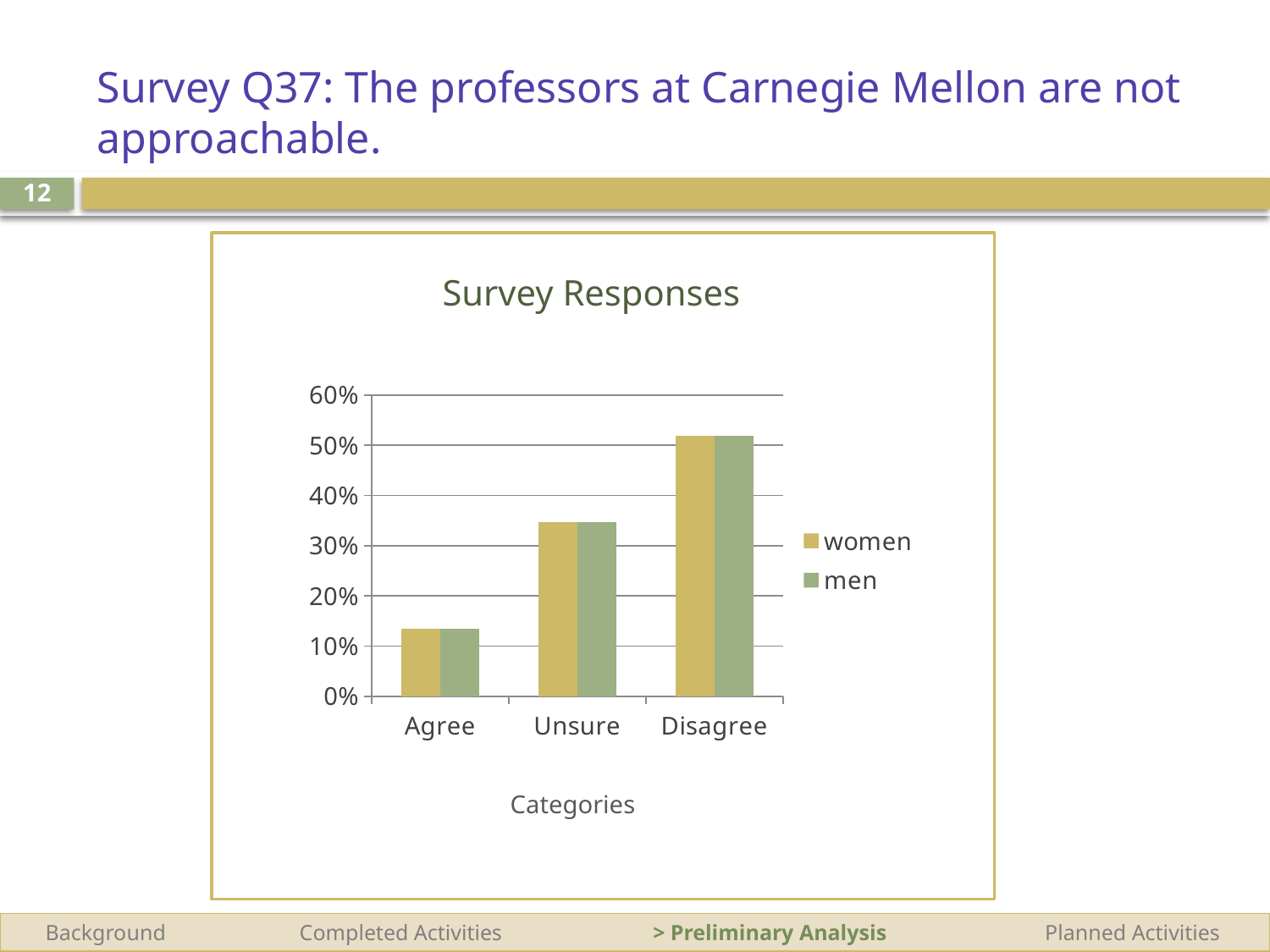
How many series does the legend list? 2 What is the label of the x axis? Categories Which category has the lowest value for men? Agree Is the value for men in the Disagree category greater or less than 40%? greater How many categories are shown on the x axis? 3 Is the value for women in the Agree category greater or less than 20%? less What kind of chart is shown on the slide? bar chart Is the value for men in the Unsure category greater or less than 40%? less Do the values for women rise or fall from Agree to Disagree along the x axis? rise What is the title of the chart? Survey Responses Which category has the highest value for women? Disagree